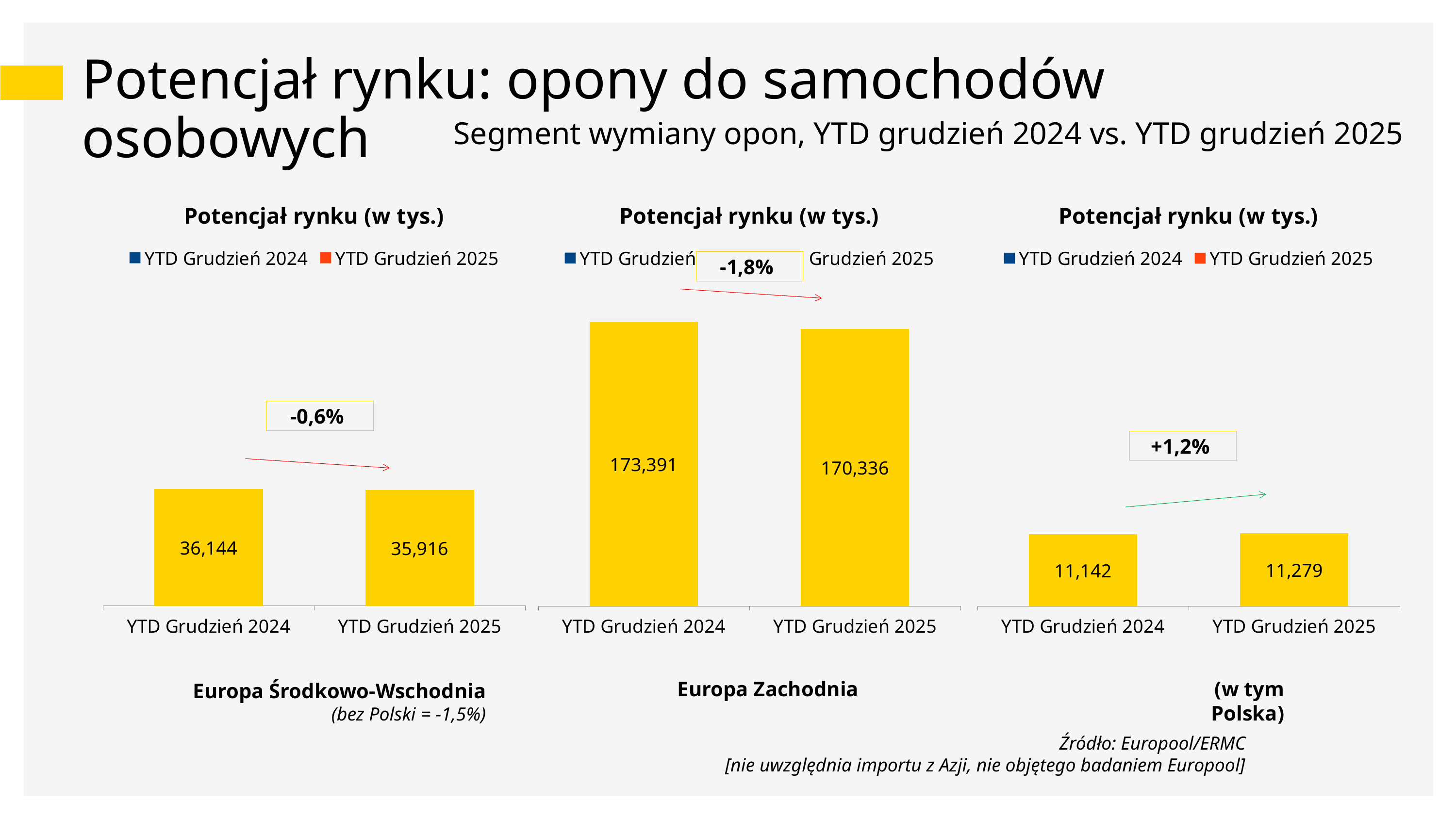
In the right chart (w tym Polska), which category has the highest value? YTD Grudzień 2025 In the middle chart (Europa Zachodnia), what is the value for YTD Grudzień 2024? 173,391 In the left chart (Europa Środkowo-Wschodnia), what is the value for YTD Grudzień 2024? 36,144 In the middle chart (Europa Zachodnia), what is the difference between the YTD Grudzień 2024 and YTD Grudzień 2025 values? 3,055 In the right chart (w tym Polska), what is the value for YTD Grudzień 2025? 11,279 In the left chart (Europa Środkowo-Wschodnia), what is the value for YTD Grudzień 2025? 35,916 In the middle chart (Europa Zachodnia), what is the value for YTD Grudzień 2025? 170,336 How many series does the legend of the left chart (Europa Środkowo-Wschodnia) list? 2 In the right chart (w tym Polska), what is the difference between the YTD Grudzień 2025 and YTD Grudzień 2024 values? 137 In the right chart (w tym Polska), what is the value for YTD Grudzień 2024? 11,142 What kind of chart is the middle chart (Europa Zachodnia)? Bar chart In the middle chart (Europa Zachodnia), which is larger: YTD Grudzień 2024 or YTD Grudzień 2025? YTD Grudzień 2024